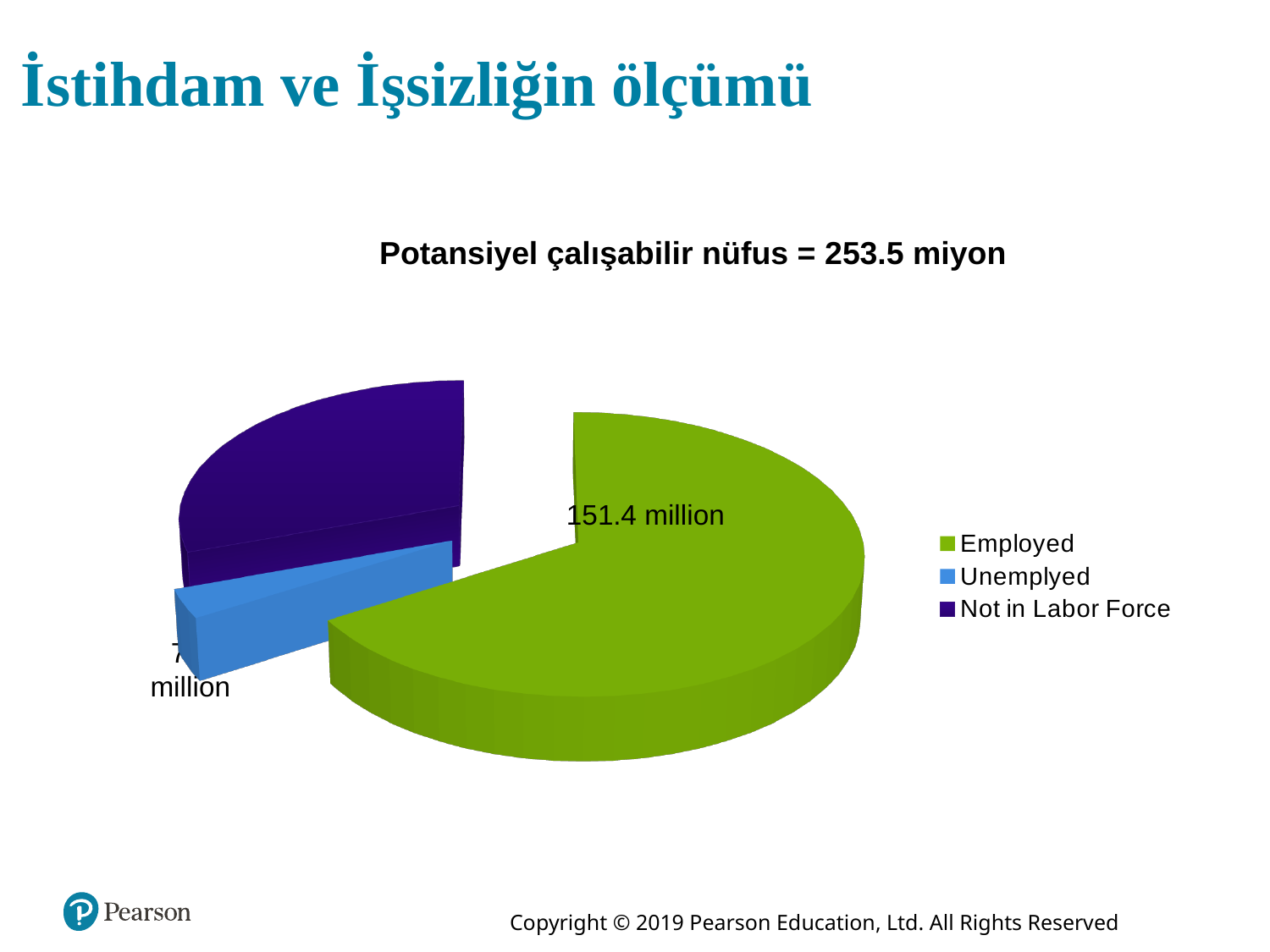
Which slice is larger in the pie chart, Employed or Not in Labor Force? Employed How many entries does the legend of the pie chart list? 3 Which category has the smallest slice in the pie chart? Unemplyed Which slice is larger in the pie chart, Not in Labor Force or Unemployed? Not in Labor Force What colour is the Employed slice in the pie chart? green How many slices does the pie chart have? 3 What value is labelled on the Employed slice of the pie chart? 151.4 million What is the title shown above the pie chart? Potansiyel çalışabilir nüfus = 253.5 miyon What kind of chart is shown on the slide? pie chart Which category has the largest slice in the pie chart? Employed